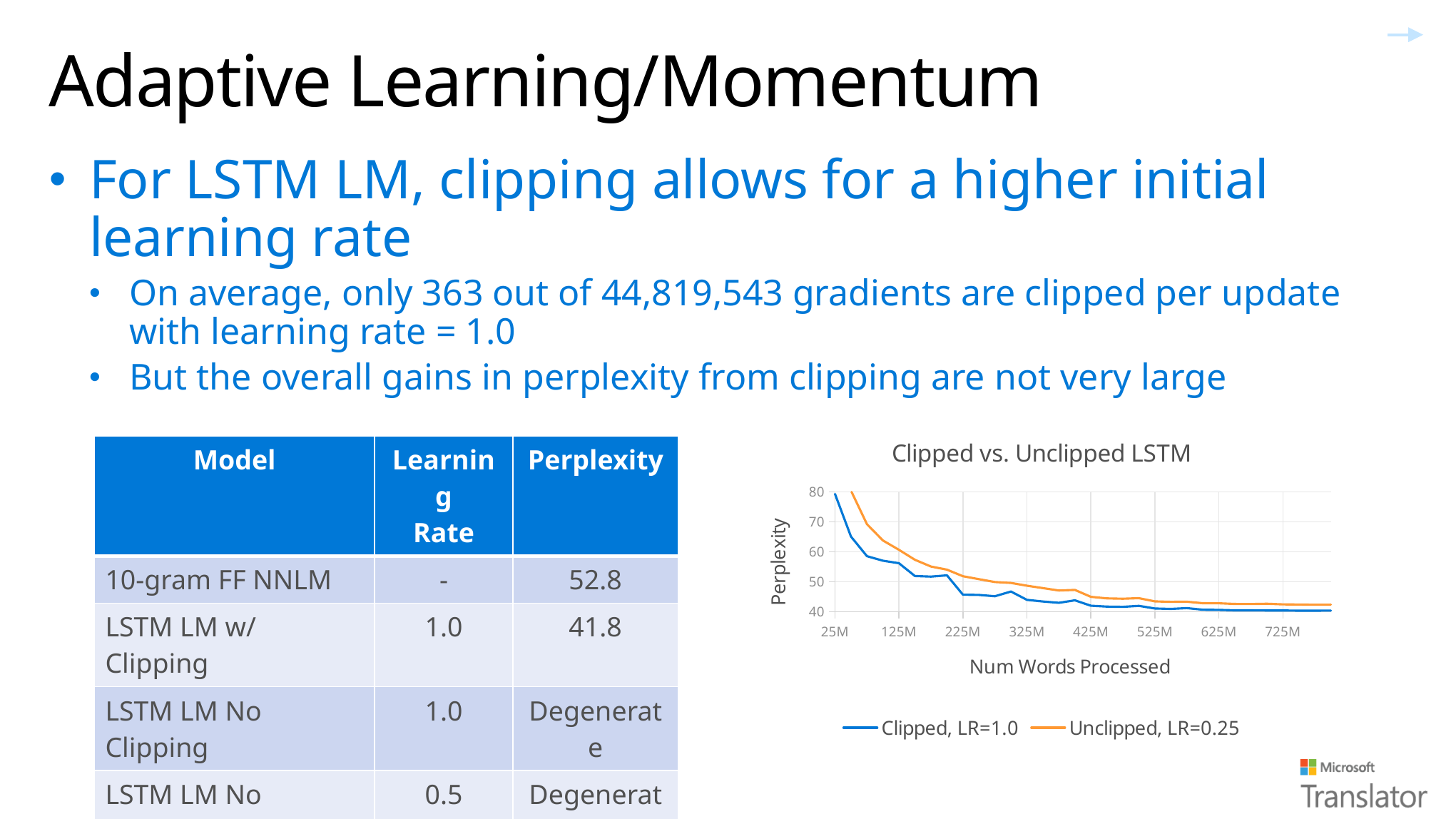
What kind of chart is "Clipped vs. Unclipped LSTM"? line chart What is the label of the y axis in the "Clipped vs. Unclipped LSTM" chart? Perplexity In the "Clipped vs. Unclipped LSTM" chart, which series has the higher perplexity at 125M words processed? Unclipped, LR=0.25 How many series does the legend of the "Clipped vs. Unclipped LSTM" chart list? 2 In the "Clipped vs. Unclipped LSTM" chart, which series has the lower perplexity at 425M words processed? Clipped, LR=1.0 In the "Clipped vs. Unclipped LSTM" chart, is the perplexity of the Clipped, LR=1.0 series at 725M words greater or less than 50? less What is the label of the x axis in the "Clipped vs. Unclipped LSTM" chart? Num Words Processed In the "Clipped vs. Unclipped LSTM" chart, is the perplexity of the Unclipped, LR=0.25 series at 125M words greater or less than 50? greater In the "Clipped vs. Unclipped LSTM" chart, does perplexity rise or fall as the number of words processed increases? fall In the "Clipped vs. Unclipped LSTM" chart, is the perplexity of the Clipped, LR=1.0 series at 125M words greater or less than 50? greater